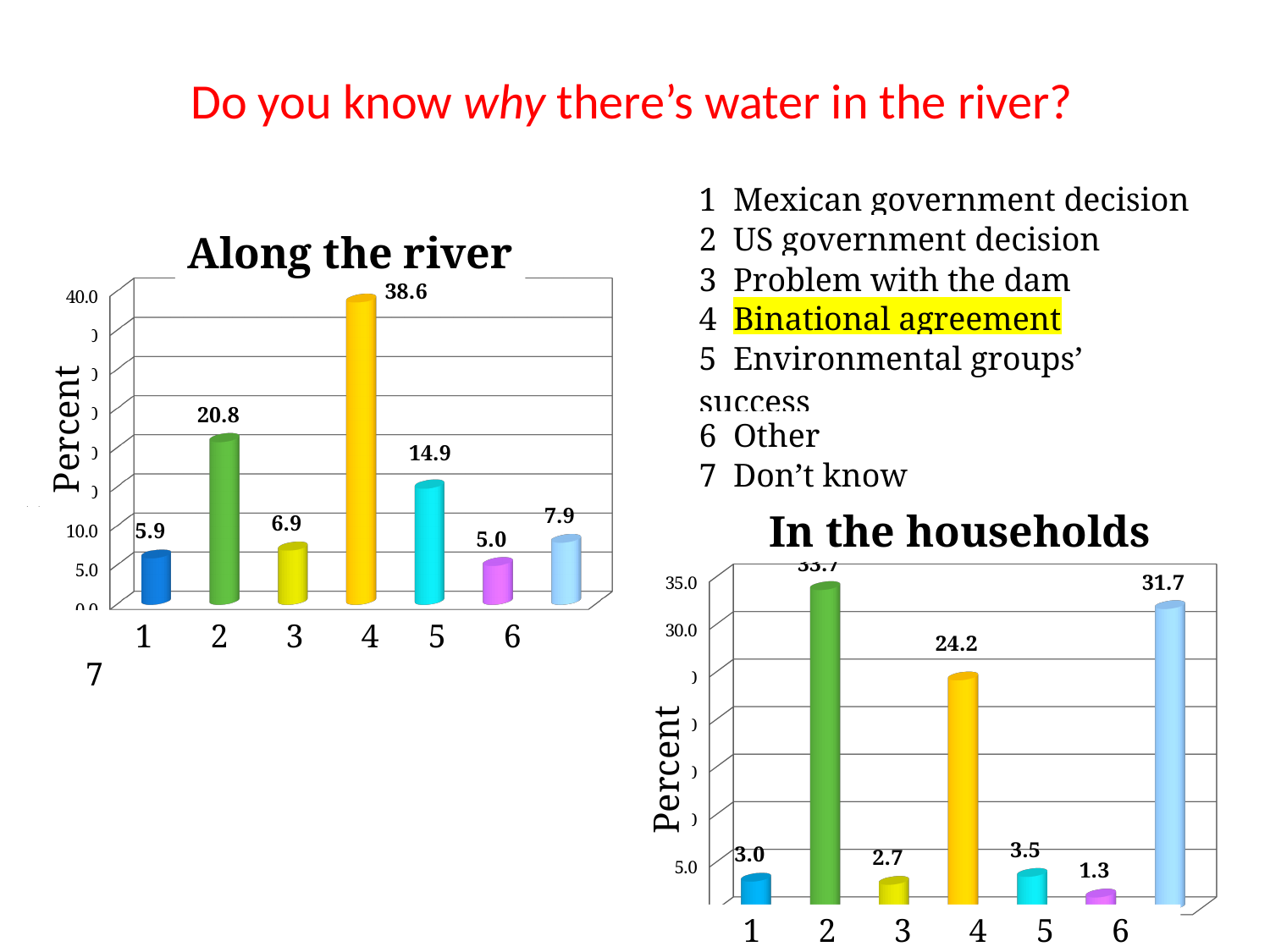
In the 'Along the river' chart, which category has the lowest value? 6 In the 'In the households' chart, which category has the lowest value? 6 In the 'In the households' chart, what is the value for category 4? 24.2 In the 'Along the river' chart, what is the difference between the values for category 4 and category 2? 17.8 In the 'In the households' chart, what is the value for category 7? 31.7 In the 'Along the river' chart, which is larger, the value for category 5 or category 7? category 5 In the 'Along the river' chart, what is the value for category 2? 20.8 What kind of chart is 'In the households'? bar chart In the 'In the households' chart, is the value for category 4 greater or less than 30.0? less In the 'Along the river' chart, what is the value for category 4? 38.6 How many categories are plotted in the 'Along the river' chart? 7 In the 'Along the river' chart, which category has the highest value? 4